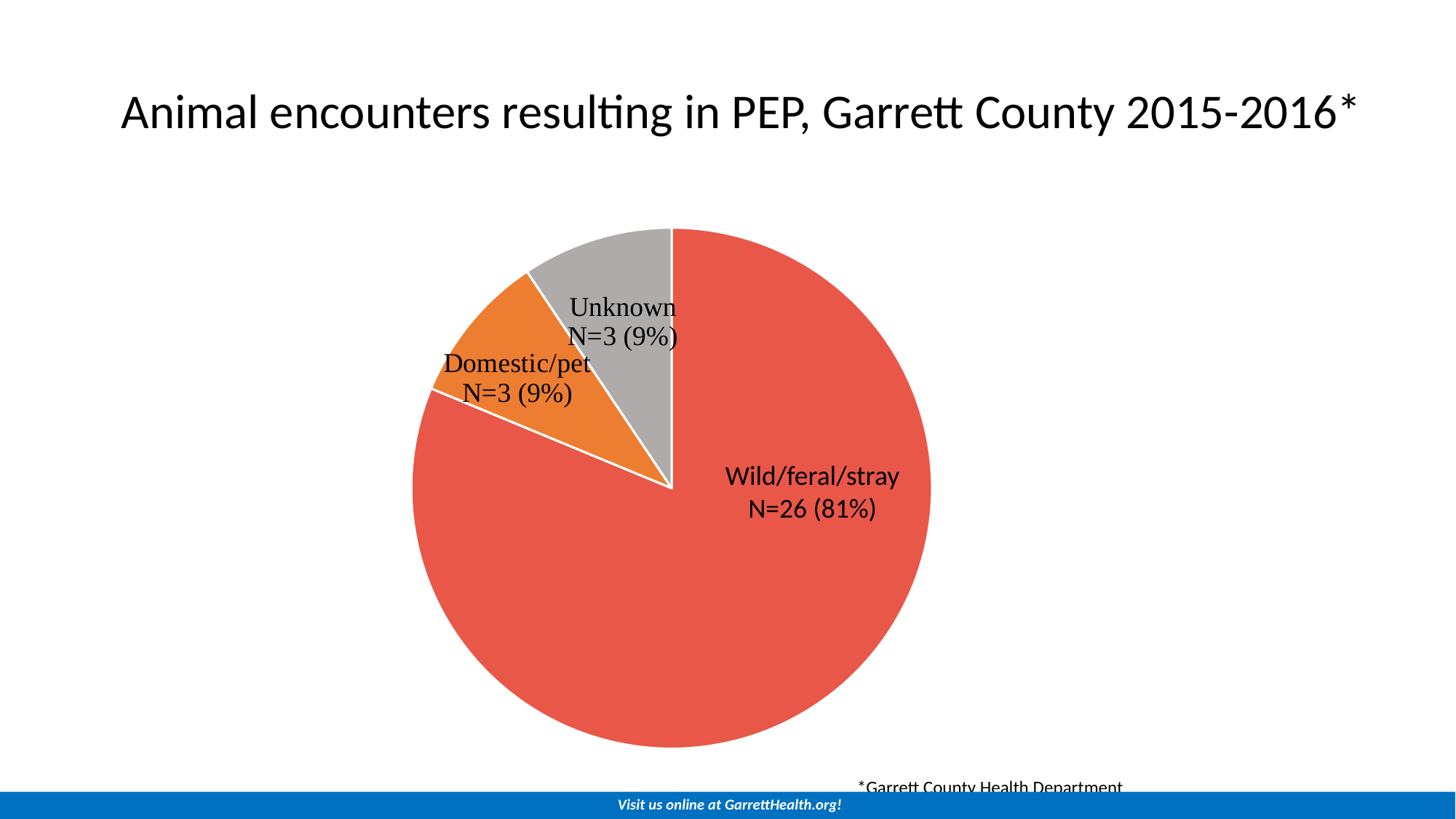
Which is larger, the N for Wild/feral/stray or the N for Unknown? Wild/feral/stray What is the difference in N between Wild/feral/stray and Domestic/pet? 23 How many slices does the pie chart have? 3 What is the N value for Wild/feral/stray? 26 Which category has the largest slice? Wild/feral/stray What share of the pie does Unknown represent? 9% What is the N value for Unknown? 3 What share of the pie does Wild/feral/stray represent? 81% What is the N value for Domestic/pet? 3 What kind of chart is shown on the slide? pie chart What is the title of the chart? Animal encounters resulting in PEP, Garrett County 2015-2016* What colour is the Domestic/pet slice? orange